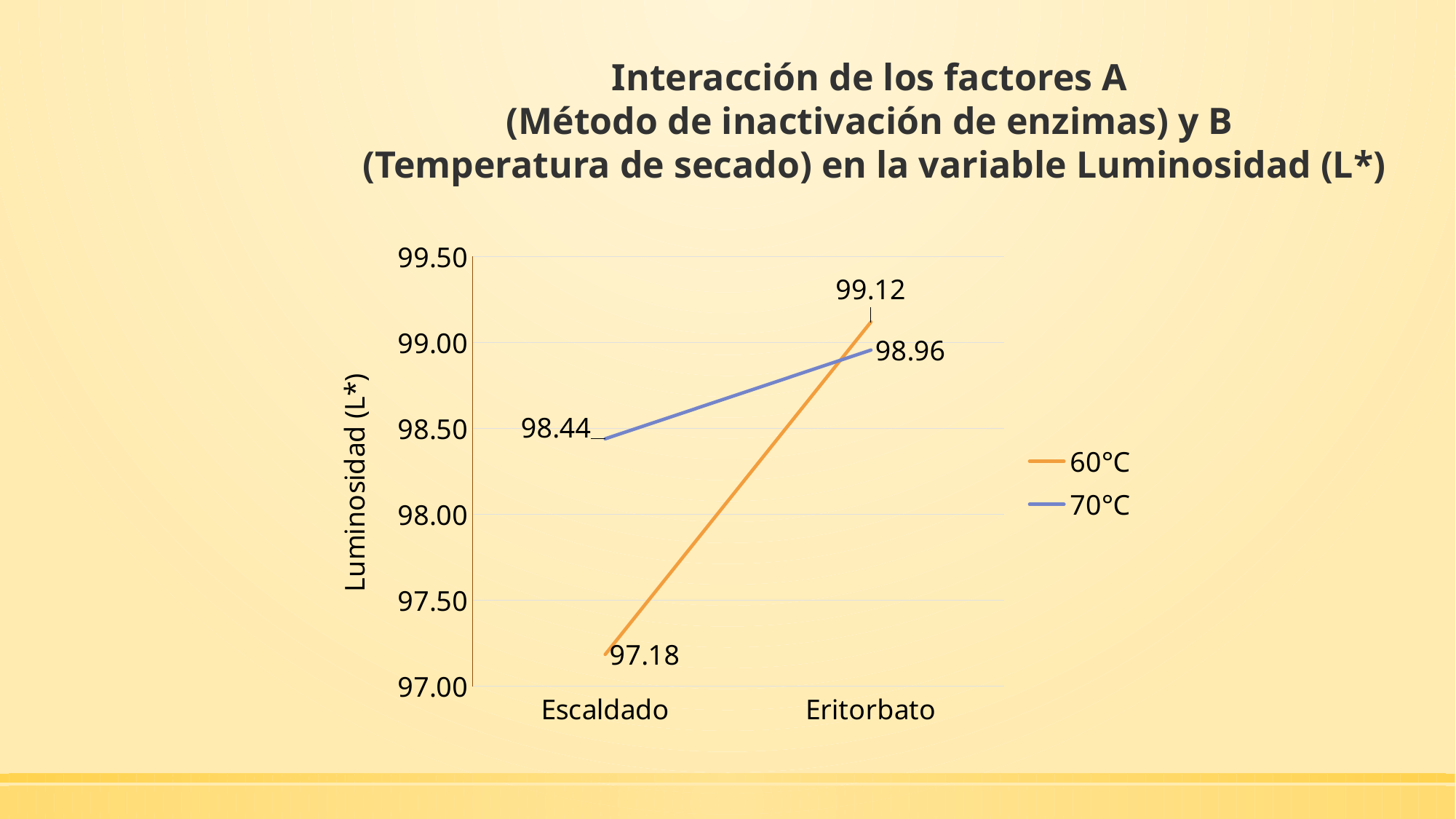
Is the value for 60°C at Escaldado greater or less than 97.50? less Which series has the highest value at Eritorbato? 60°C Which is larger at Escaldado: the 60°C value or the 70°C value? 70°C What is the difference between the 60°C values at Eritorbato and Escaldado? 1.94 How many series does the legend list? 2 What is the Luminosidad (L*) value for 70°C at Escaldado? 98.44 What kind of chart is shown on the slide? line chart Which series has the lowest value at Escaldado? 60°C How many categories are shown on the x axis? 2 What is the Luminosidad (L*) value for 60°C at Eritorbato? 99.12 What is the Luminosidad (L*) value for 60°C at Escaldado? 97.18 What is the Luminosidad (L*) value for 70°C at Eritorbato? 98.96